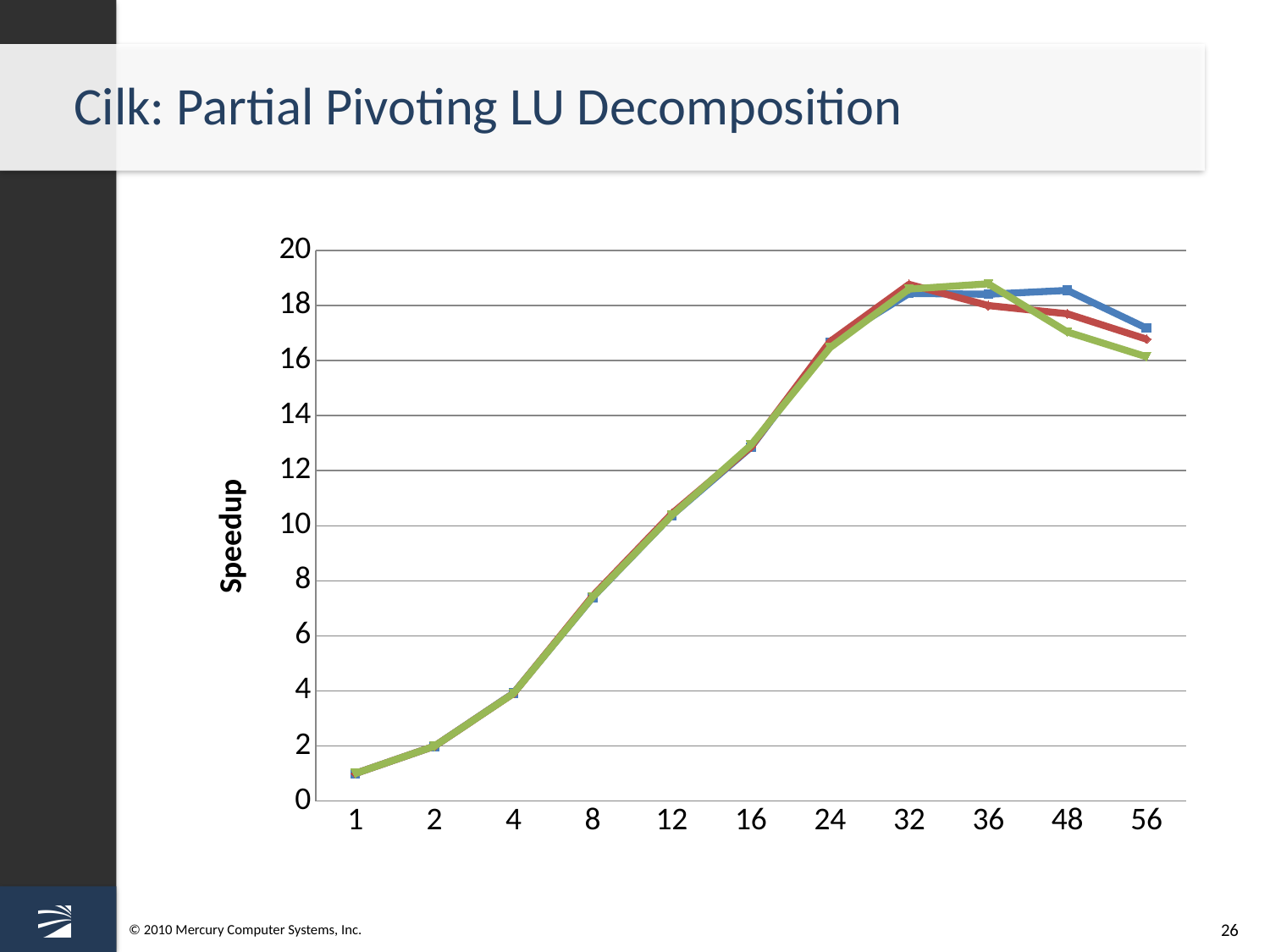
Do the speedup values rise or fall along the x axis from 1 to 32? rise Is the speedup at x = 8 greater or less than 6? greater Is the speedup at x = 1 greater or less than 2? less At x = 48, which line has the higher speedup, the blue line or the green line? blue How many lines are plotted on the chart? 3 Is the value of the blue line at x = 56 greater or less than 16? greater What kind of chart is shown on the slide? line chart What is the label of the vertical axis? Speedup What is the title of the chart on the slide? Cilk: Partial Pivoting LU Decomposition How many points are marked along the x axis? 11